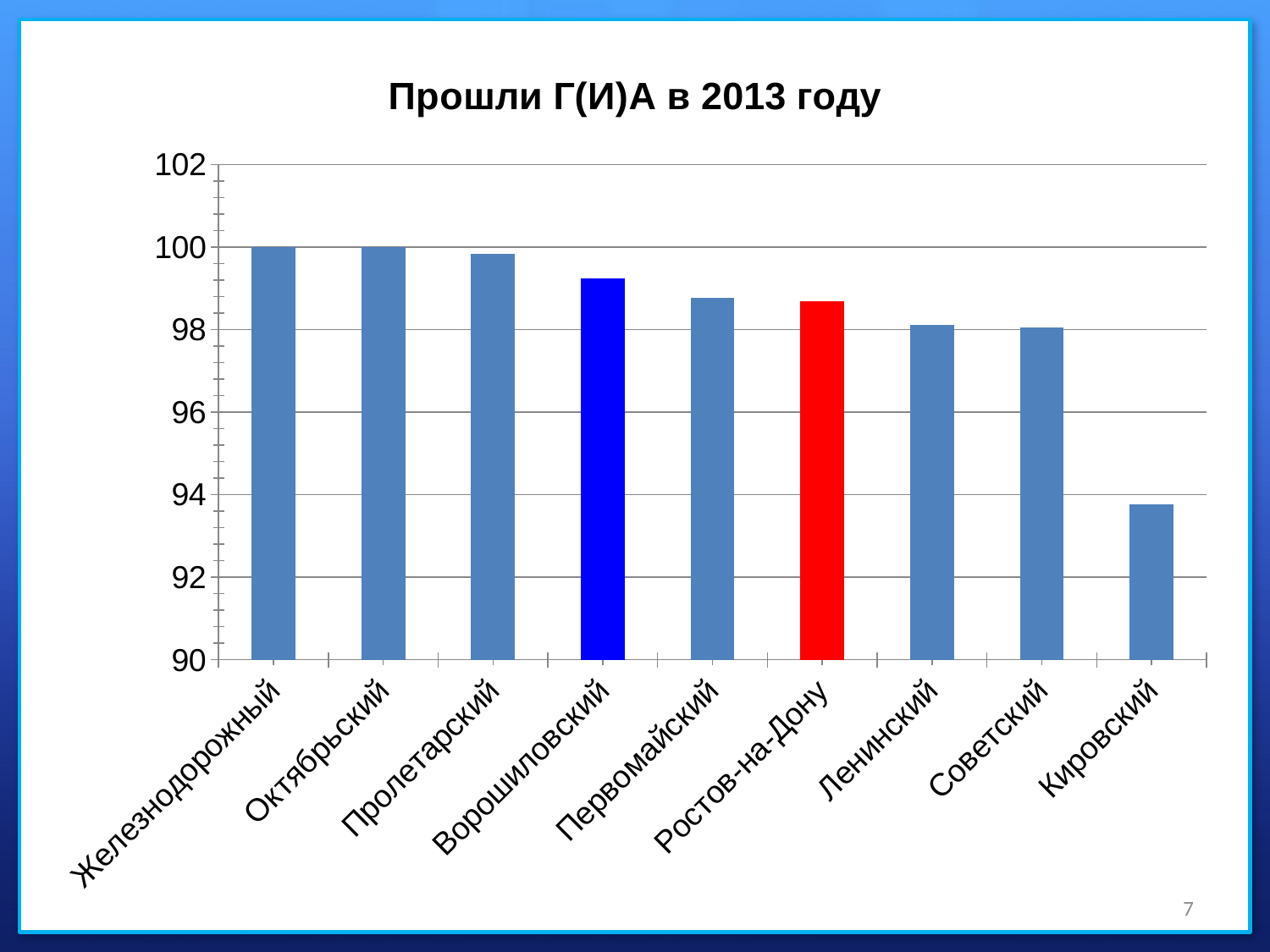
Which is larger, the value for Ворошиловский or the value for Ленинский? Ворошиловский What kind of chart is shown on the slide? Bar chart Do the values generally rise or fall from left to right along the x axis? fall Which category has the lowest value? Кировский What is the value for Железнодорожный? 100 Which is larger, the value for Пролетарский or the value for Кировский? Пролетарский Is the value for Ворошиловский greater or less than 98? greater Is the value for Ростов-на-Дону greater or less than 100? less How many categories are plotted on the chart? 9 What is the title of the chart? Прошли Г(И)А в 2013 году What colour is the bar for Ростов-на-Дону? Red Is the value for Кировский greater or less than 94? less